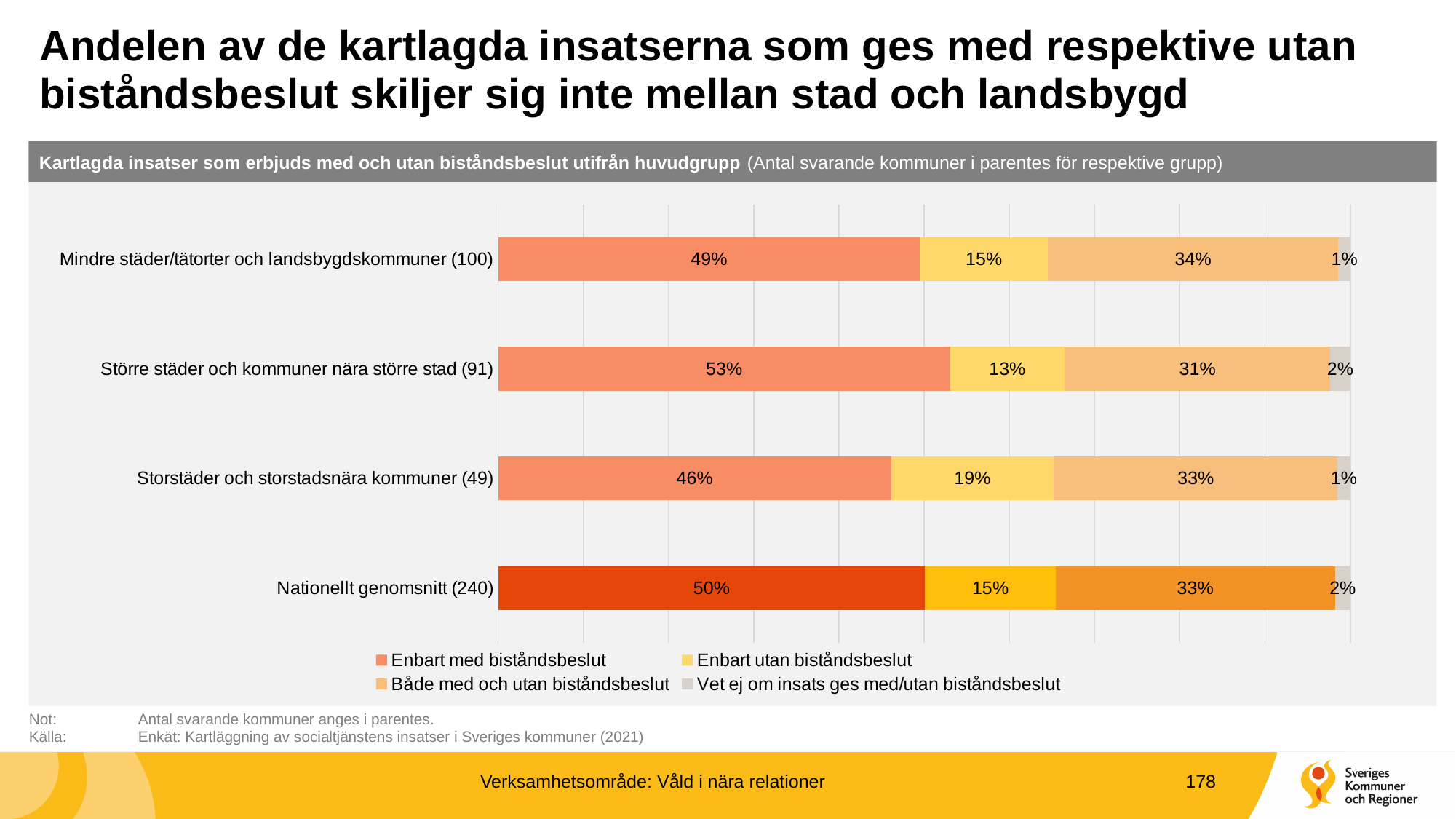
What is the value of 'Vet ej om insats ges med/utan biståndsbeslut' for 'Nationellt genomsnitt (240)'? 2% Which legend entry is shown in grey? Vet ej om insats ges med/utan biståndsbeslut Which category has the highest value for 'Enbart med biståndsbeslut'? Större städer och kommuner nära större stad (91) Which category has the lowest value for 'Enbart utan biståndsbeslut'? Större städer och kommuner nära större stad (91) What is the difference between the 'Enbart med biståndsbeslut' values for 'Större städer och kommuner nära större stad (91)' and 'Storstäder och storstadsnära kommuner (49)'? 7 percentage points How many series does the legend list? 4 How many categories (bars) does the chart show? 4 What is the value of 'Både med och utan biståndsbeslut' for 'Mindre städer/tätorter och landsbygdskommuner (100)'? 34% What is the value of 'Enbart med biståndsbeslut' for 'Större städer och kommuner nära större stad (91)'? 53% What is the value of 'Enbart utan biståndsbeslut' for 'Storstäder och storstadsnära kommuner (49)'? 19% Which is larger: the 'Både med och utan biståndsbeslut' value for 'Mindre städer/tätorter och landsbygdskommuner (100)' or for 'Större städer och kommuner nära större stad (91)'? Mindre städer/tätorter och landsbygdskommuner (100) What kind of chart is shown on the slide? Stacked bar chart